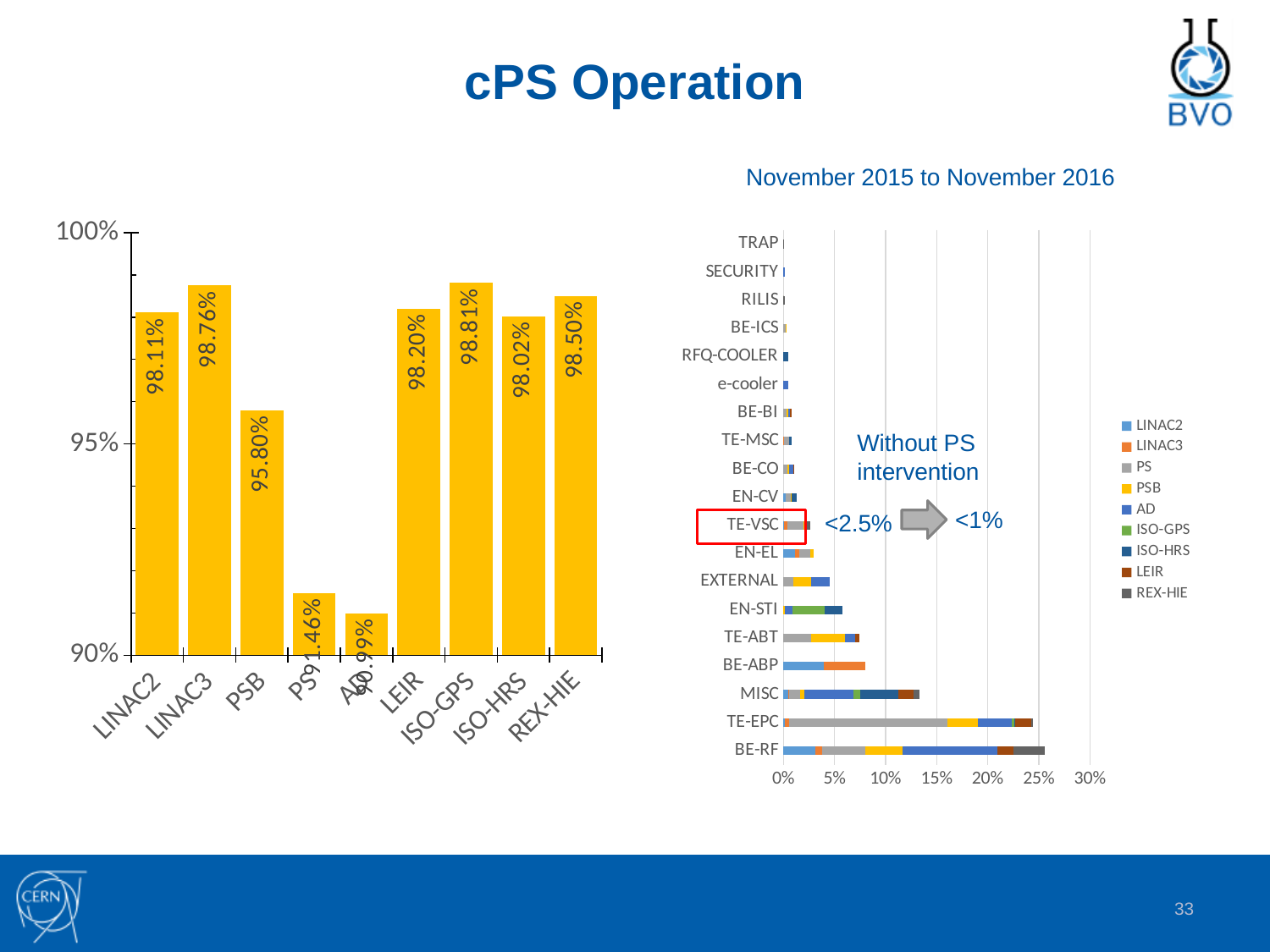
In the right chart, is the total bar length for EN-STI greater or less than 10%? less In the left bar chart, what is the value for LINAC3? 98.76% In the left bar chart, which category has the highest value? ISO-GPS In the right chart, which category has the longest bar? BE-RF In the left bar chart, what is the value for PSB? 95.80% How many series does the legend of the right chart list? 9 In the right chart, is the total bar length for BE-RF greater or less than 20%? greater In the left bar chart, which is larger, the value for LEIR or the value for ISO-HRS? LEIR In the left bar chart, which category has the lowest value? AD In the left bar chart, what is the difference between the values for LINAC3 and LINAC2? 0.65% What kind of chart is the chart on the right of the slide? Stacked horizontal bar chart How many categories are shown in the left bar chart? 9